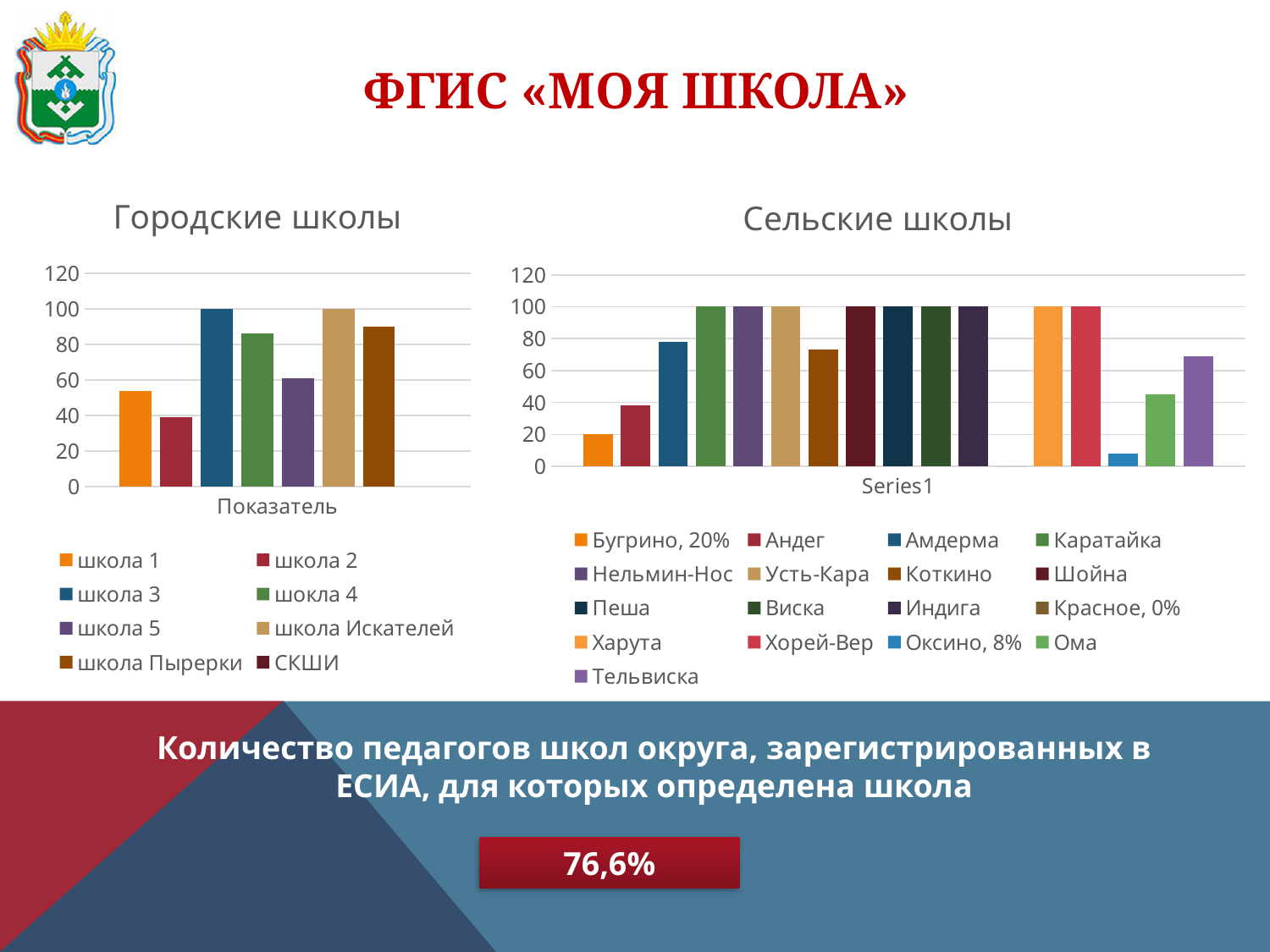
How many series does the legend of the 'Городские школы' chart list? 8 In the 'Городские школы' chart, which is larger, школа 3 or школа 2? школа 3 How many series does the legend of the 'Сельские школы' chart list? 17 In the 'Городские школы' chart, is the value for школа 1 greater or less than 40? greater What kind of chart is the 'Городские школы' chart? bar chart In the 'Сельские школы' chart, what is the difference between the values for Бугрино and Оксино? 12% In the 'Сельские школы' chart, what is the value for Оксино? 8% In the 'Городские школы' chart, what is the value for школа 3? 100 In the 'Сельские школы' chart, what is the value for Красное? 0% In the 'Сельские школы' chart, is the value for Коткино greater or less than 80? less In the 'Сельские школы' chart, what is the value for Бугрино? 20% In the 'Сельские школы' chart, which is larger, Тельвиска or Ома? Тельвиска